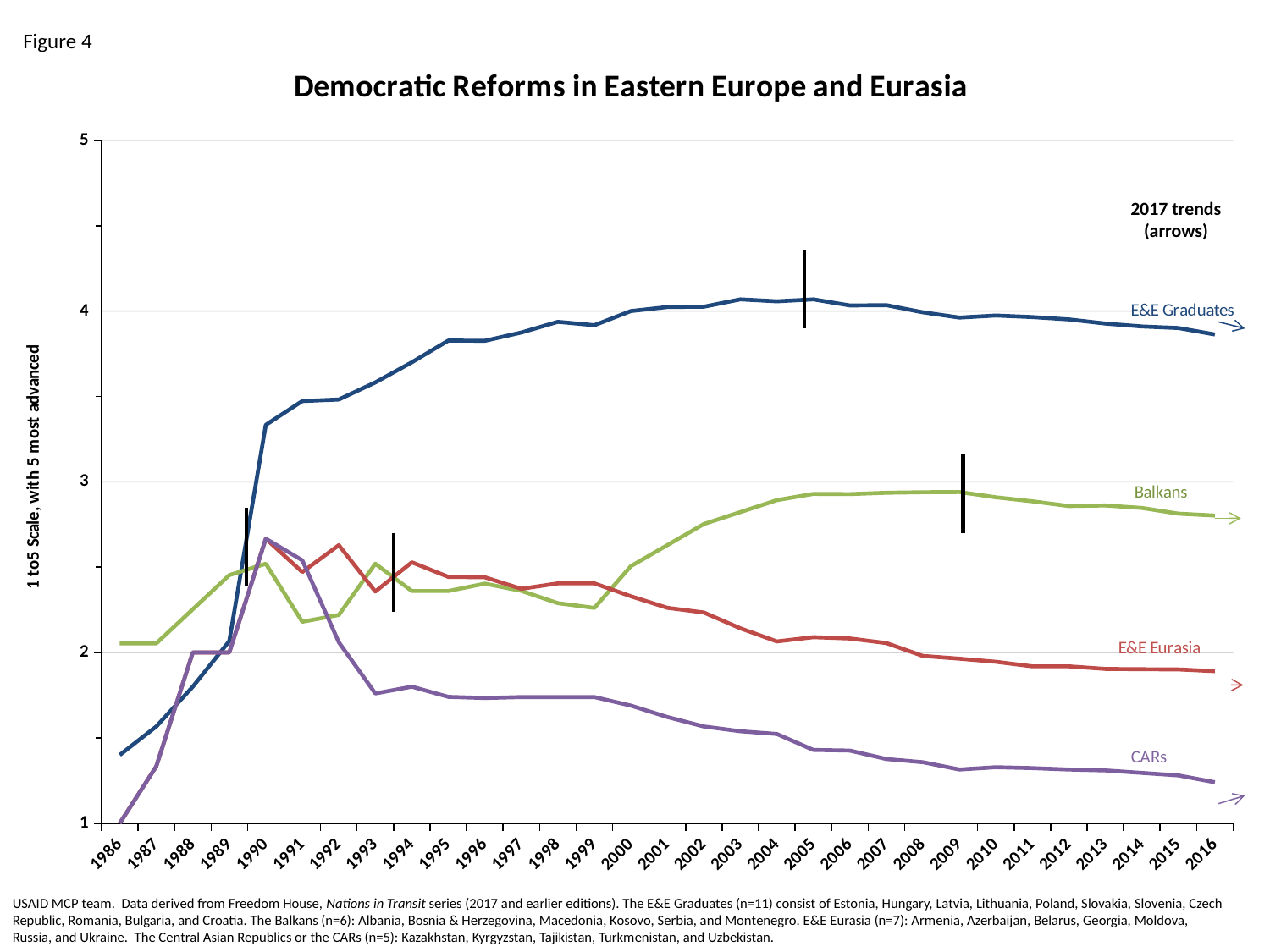
Which series has the highest value in 2016? E&E Graduates What kind of chart is shown on the slide? line chart Is the value for E&E Graduates in 2016 greater or less than 4? less What is the title of the chart? Democratic Reforms in Eastern Europe and Eurasia Does the E&E Graduates line rise or fall between 1986 and 1990? rise Does the CARs line rise or fall between 2000 and 2016? fall In 2016, which series has the higher value: Balkans or E&E Eurasia? Balkans How many years are shown along the x axis of the chart? 31 Is the value for CARs in 2004 greater or less than 2? less Which series has the lowest value in 2016? CARs How many data series are plotted on the chart? 4 Is the value for E&E Eurasia in 2016 greater or less than 2? less